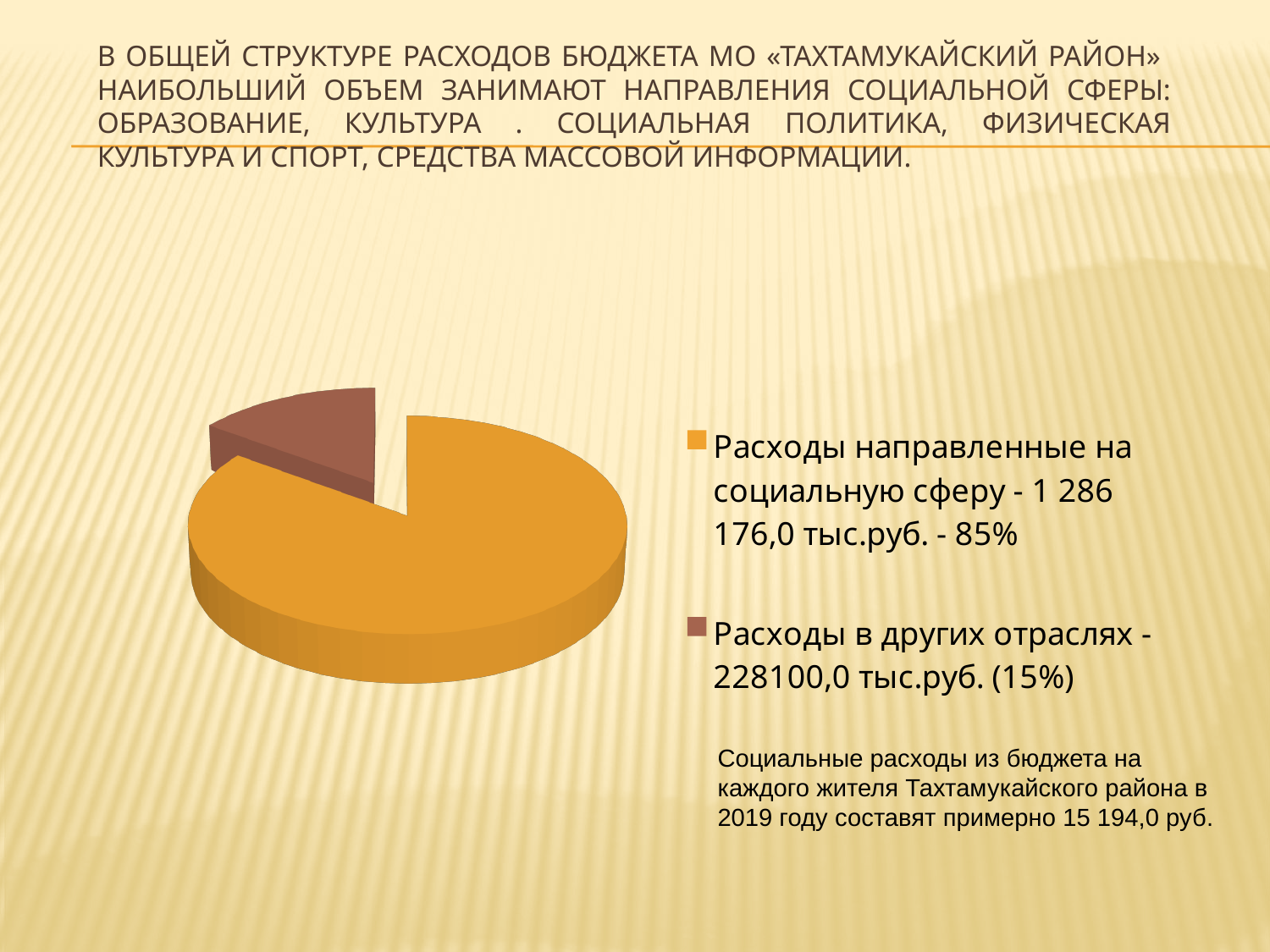
How many slices does the pie chart have? 2 Which category has the smallest slice of the pie? Расходы в других отраслях What share of the pie is taken by "Расходы направленные на социальную сферу"? 85% What colour is the slice for "Расходы в других отраслях"? brown What is the value shown for "Расходы направленные на социальную сферу"? 1 286 176,0 тыс.руб. What kind of chart is shown on the slide? pie chart By how many percentage points does the share of "Расходы направленные на социальную сферу" exceed the share of "Расходы в других отраслях"? 70 What share of the pie is taken by "Расходы в других отраслях"? 15% Which is larger: the share for "Расходы направленные на социальную сферу" or for "Расходы в других отраслях"? Расходы направленные на социальную сферу How many entries does the legend of the pie chart list? 2 Which category has the largest slice of the pie? Расходы направленные на социальную сферу What is the value shown for "Расходы в других отраслях"? 228100,0 тыс.руб.